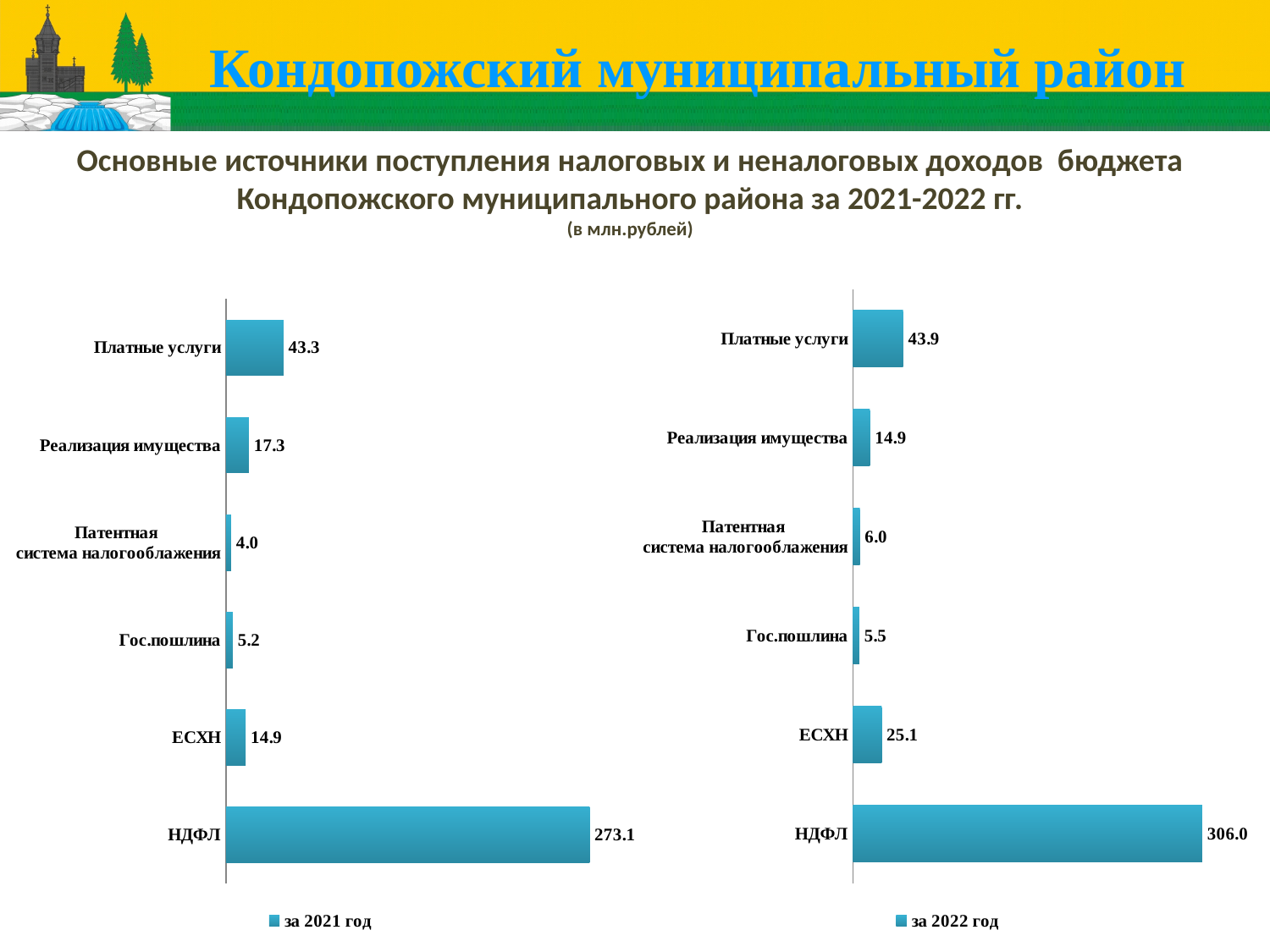
In the right chart (за 2022 год), which category has the lowest value? Гос.пошлина In the right chart (за 2022 год), what is the value for ЕСХН? 25.1 What kind of chart is the right chart (за 2022 год)? Bar chart In the right chart (за 2022 год), which category has the highest value? НДФЛ In the left chart (за 2021 год), what is the value for Реализация имущества? 17.3 In the left chart (за 2021 год), which category has the lowest value? Патентная система налогооблажения What is the difference between the НДФЛ value in the right chart (за 2022 год) and the НДФЛ value in the left chart (за 2021 год)? 32.9 In the right chart (за 2022 год), what is the value for Платные услуги? 43.9 What is the legend entry of the left chart? за 2021 год In the left chart (за 2021 год), what is the value for НДФЛ? 273.1 Which is larger: ЕСХН in the left chart (за 2021 год) or ЕСХН in the right chart (за 2022 год)? за 2022 год How many categories does the left chart (за 2021 год) show? 6